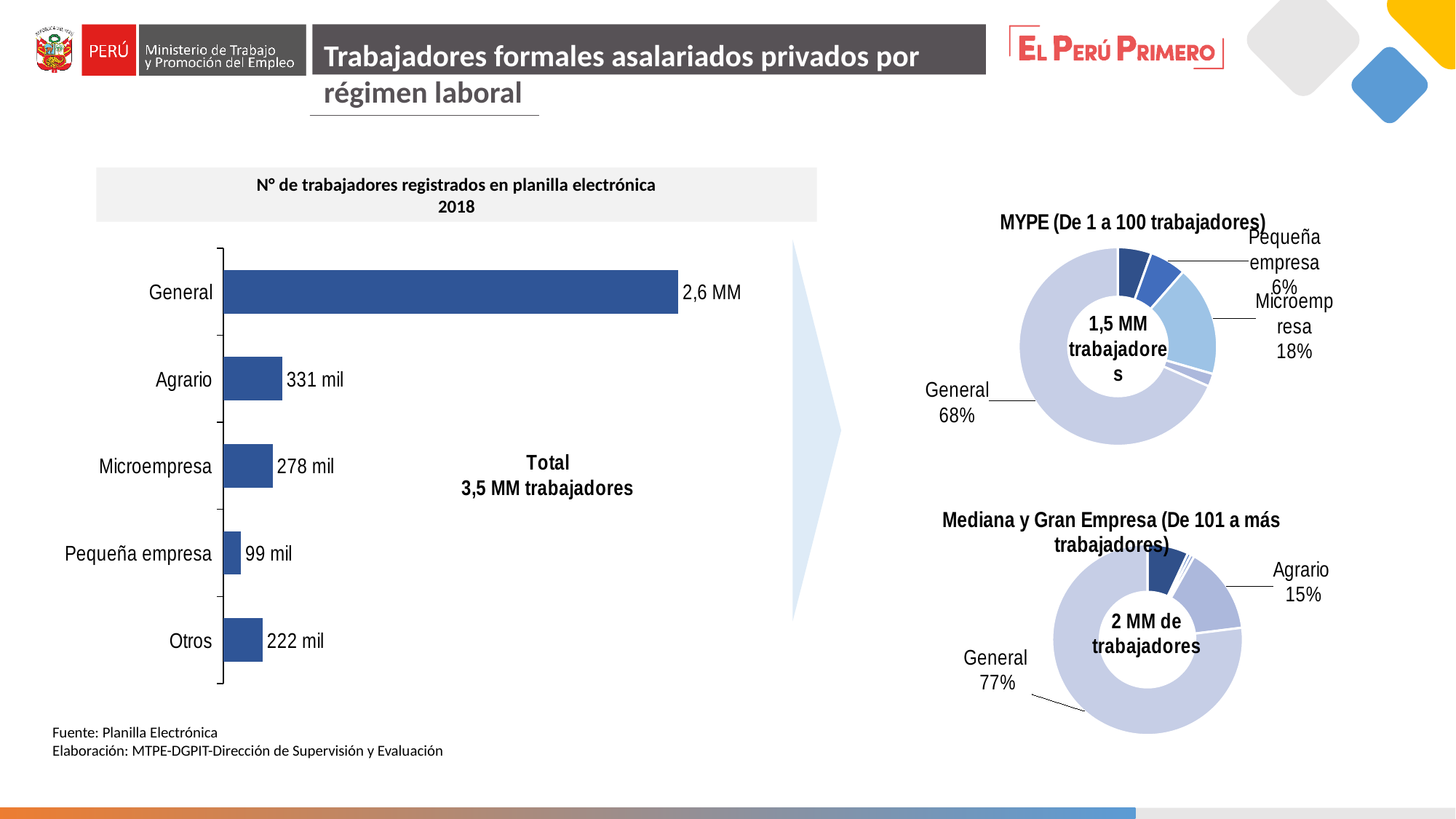
In the 'MYPE (De 1 a 100 trabajadores)' donut chart, what share does Microempresa have? 18% How many categories does the bar chart 'N° de trabajadores registrados en planilla electrónica 2018' show? 5 In the 'MYPE (De 1 a 100 trabajadores)' donut chart, what share does General have? 68% What total number of workers is shown in the centre of the 'Mediana y Gran Empresa (De 101 a más trabajadores)' donut chart? 2 MM de trabajadores In the bar chart 'N° de trabajadores registrados en planilla electrónica 2018', what is the value for Agrario? 331 mil In the bar chart 'N° de trabajadores registrados en planilla electrónica 2018', which category has the highest value? General What kind of chart is 'N° de trabajadores registrados en planilla electrónica 2018'? Bar chart In the bar chart 'N° de trabajadores registrados en planilla electrónica 2018', which is larger, Otros or Microempresa? Microempresa In the bar chart 'N° de trabajadores registrados en planilla electrónica 2018', which category has the lowest value? Pequeña empresa In the 'Mediana y Gran Empresa (De 101 a más trabajadores)' donut chart, what share does Agrario have? 15% In the bar chart 'N° de trabajadores registrados en planilla electrónica 2018', what is the difference between Agrario and Microempresa? 53 mil In the bar chart 'N° de trabajadores registrados en planilla electrónica 2018', what is the value for General? 2,6 MM